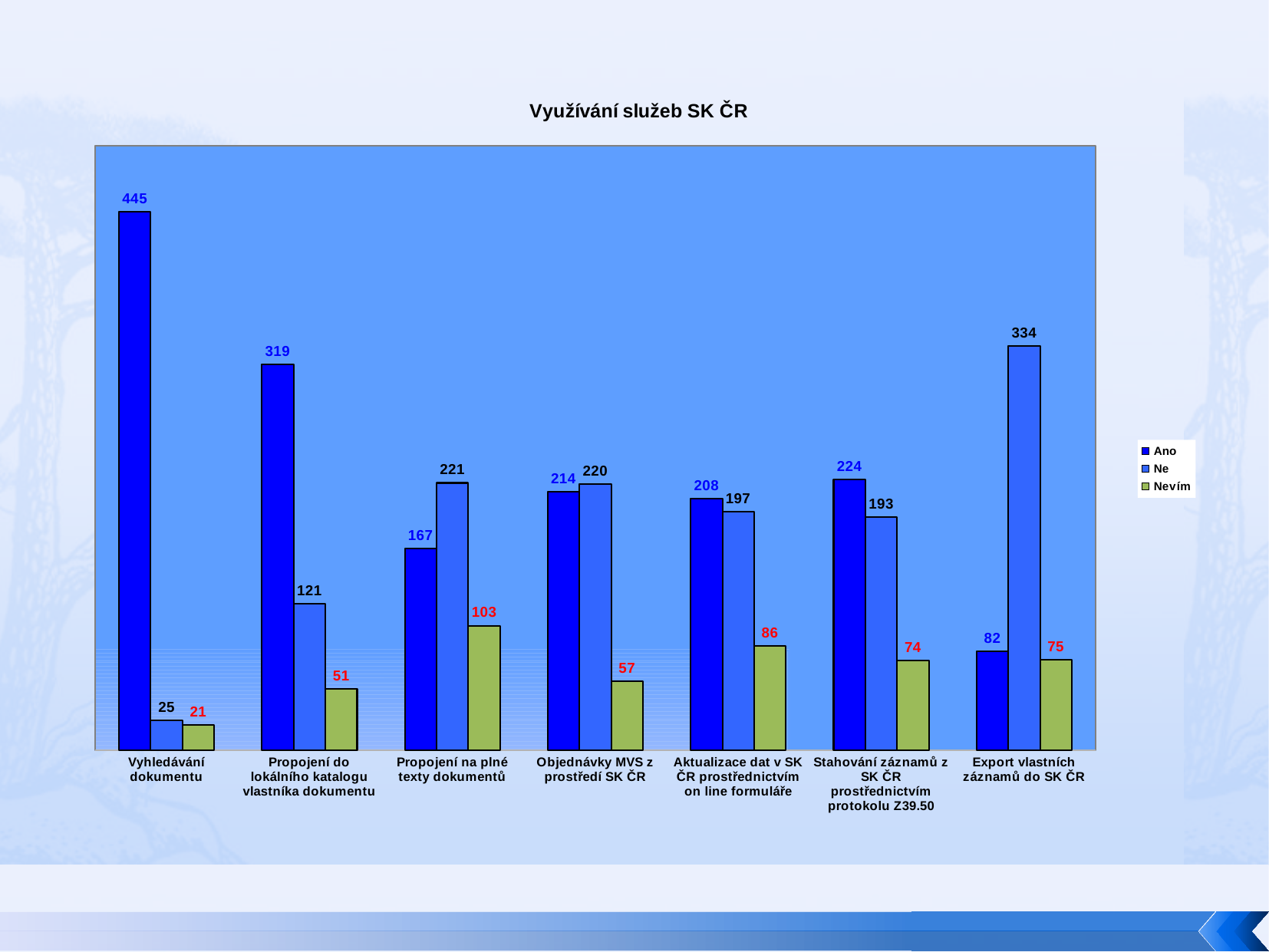
Which category has the highest "Ano" value? Vyhledávání dokumentu What kind of chart is shown on the slide? Bar chart What is the difference between the "Ano" and "Ne" values for "Propojení do lokálního katalogu vlastníka dokumentu"? 198 Which category has the lowest "Nevím" value? Vyhledávání dokumentu How many categories are shown on the x axis? 7 What is the value of "Nevím" for "Propojení na plné texty dokumentů"? 103 What is the value of "Ne" for "Export vlastních záznamů do SK ČR"? 334 What is the value of "Ne" for "Aktualizace dat v SK ČR prostřednictvím on line formuláře"? 197 For "Export vlastních záznamů do SK ČR", which is larger: "Ano" or "Ne"? Ne How many series does the legend list? 3 What is the value of "Ano" for "Vyhledávání dokumentu"? 445 What is the title of the chart? Využívání služeb SK ČR